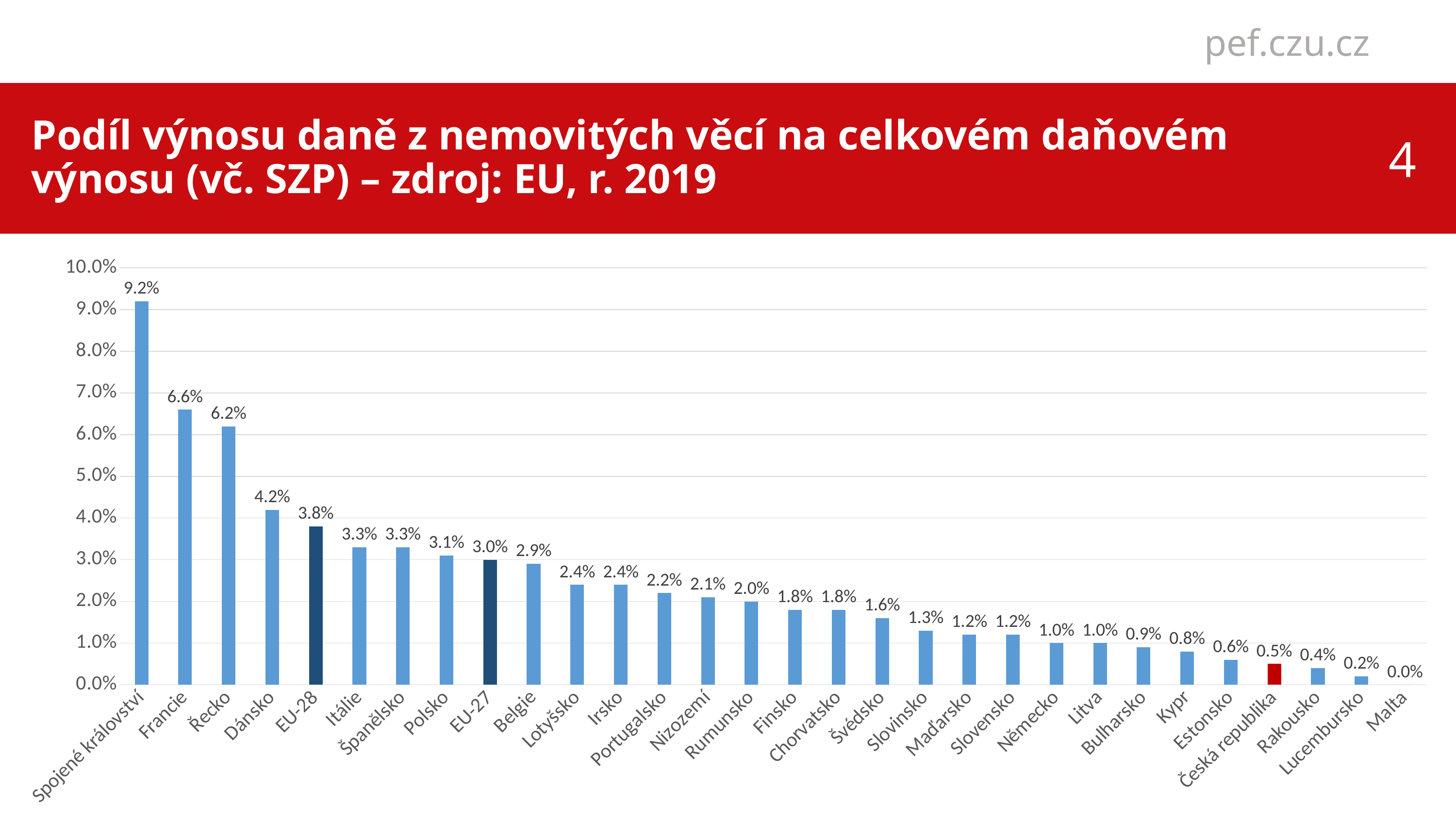
Which category has the lowest value? Malta Which is larger, the value for Dánsko or the value for Belgie? Dánsko Which bar is coloured red? Česká republika What is the value for Francie? 6.6% What is the difference between the values for EU-28 and Česká republika? 3.3% What kind of chart is shown on the slide? bar chart Which category has the highest value? Spojené království What is the difference between the values for Spojené království and Francie? 2.6% What is the value for Polsko? 3.1% How many categories are shown on the x axis? 30 What is the value for Česká republika? 0.5% What is the value for EU-27? 3.0%